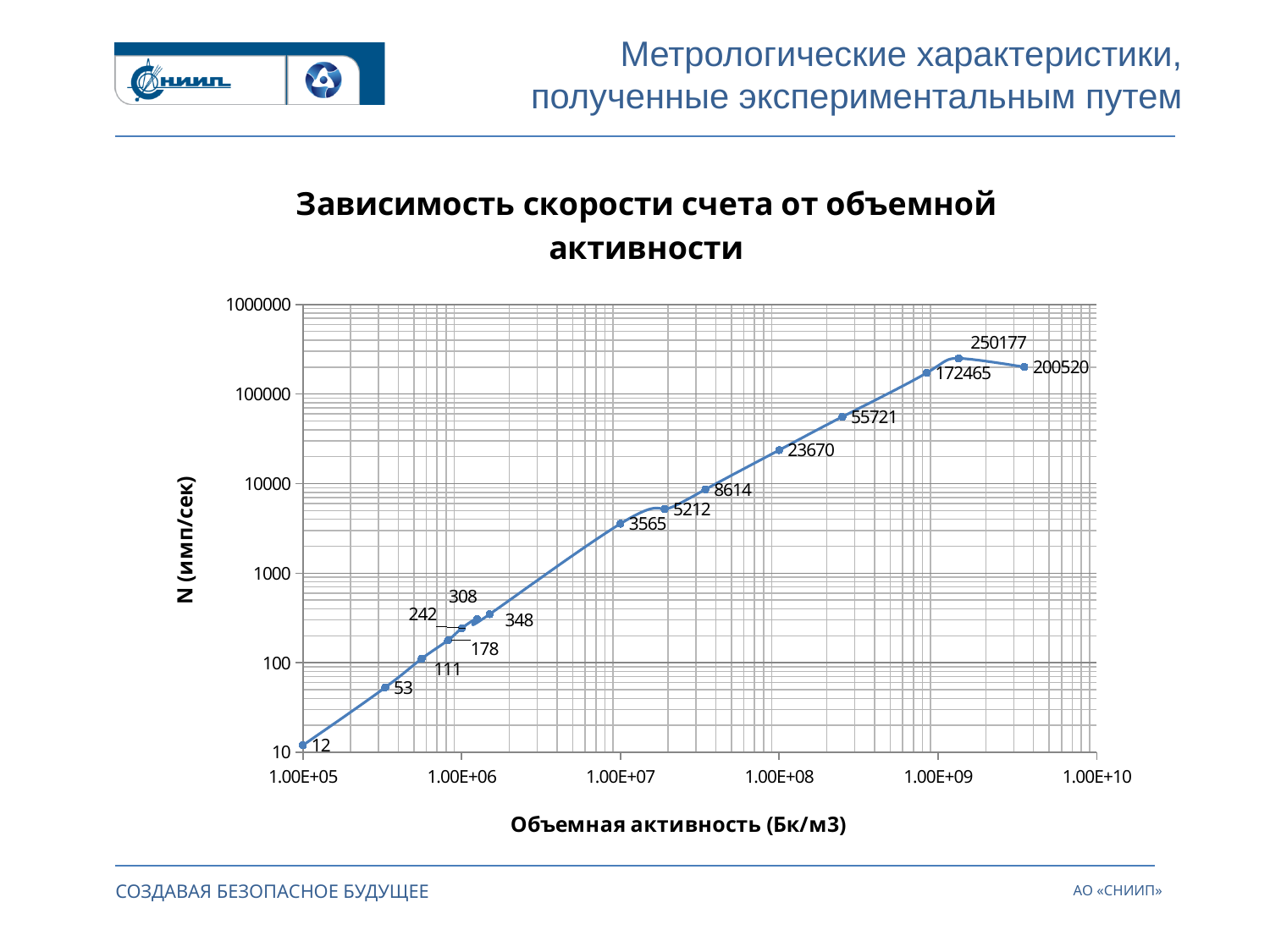
What is the label of the x axis of the chart? Объемная активность (Бк/м3) Is the value of the point labeled 3565 greater or less than 1000 on the y axis? greater Which is larger, the last point (200520) or the point before it (250177)? 250177 What is the title of the chart? Зависимость скорости счета от объемной активности Do the values generally rise or fall as volume activity increases along the x axis? rise Which is larger, the point labeled 8614 or the point labeled 5212? 8614 What is the lowest data-label value plotted on the chart? 12 What kind of chart is shown on the slide? line chart What is the difference between the highest labeled value (250177) and the last labeled value (200520)? 49657 What is the highest data-label value plotted on the chart? 250177 What is the difference between the points labeled 55721 and 23670? 32051 What is the difference between the points labeled 348 and 308? 40